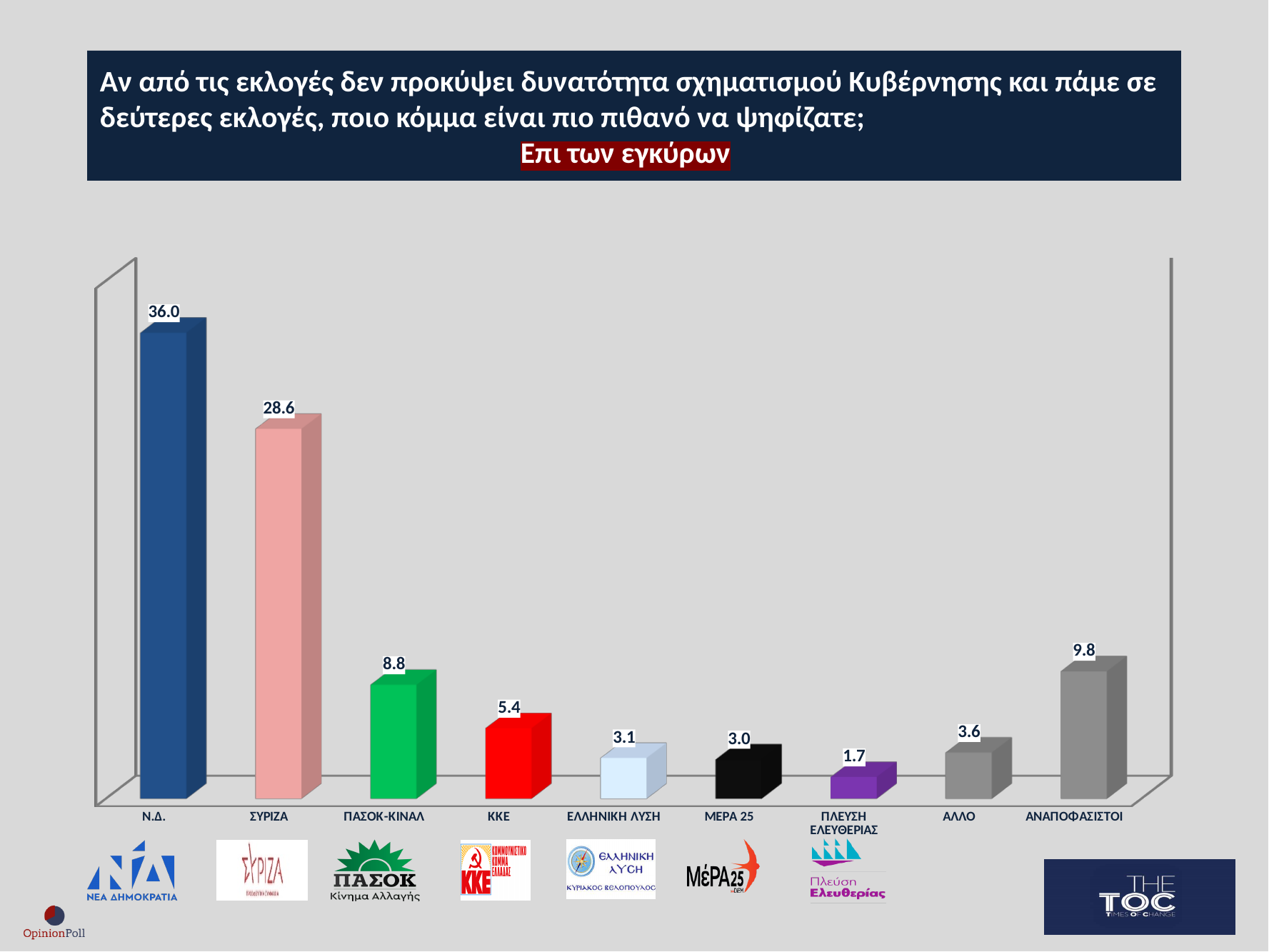
What is the value for ΠΑΣΟΚ-ΚΙΝΑΛ? 8.8 Which is larger, the value for ΚΚΕ or the value for ΑΛΛΟ? ΚΚΕ Which category has the lowest value? ΠΛΕΥΣΗ ΕΛΕΥΘΕΡΙΑΣ How many categories are shown on the x axis? 9 What is the difference between the values for Ν.Δ. and ΣΥΡΙΖΑ? 7.4 What is the value for ΑΝΑΠΟΦΑΣΙΣΤΟΙ? 9.8 What is the value for ΣΥΡΙΖΑ? 28.6 Which category has the highest value? Ν.Δ. What colour is the bar for ΠΑΣΟΚ-ΚΙΝΑΛ? green What is the value for Ν.Δ.? 36.0 What kind of chart is shown on the slide? bar chart What is the difference between the values for ΕΛΛΗΝΙΚΗ ΛΥΣΗ and ΜΕΡΑ 25? 0.1